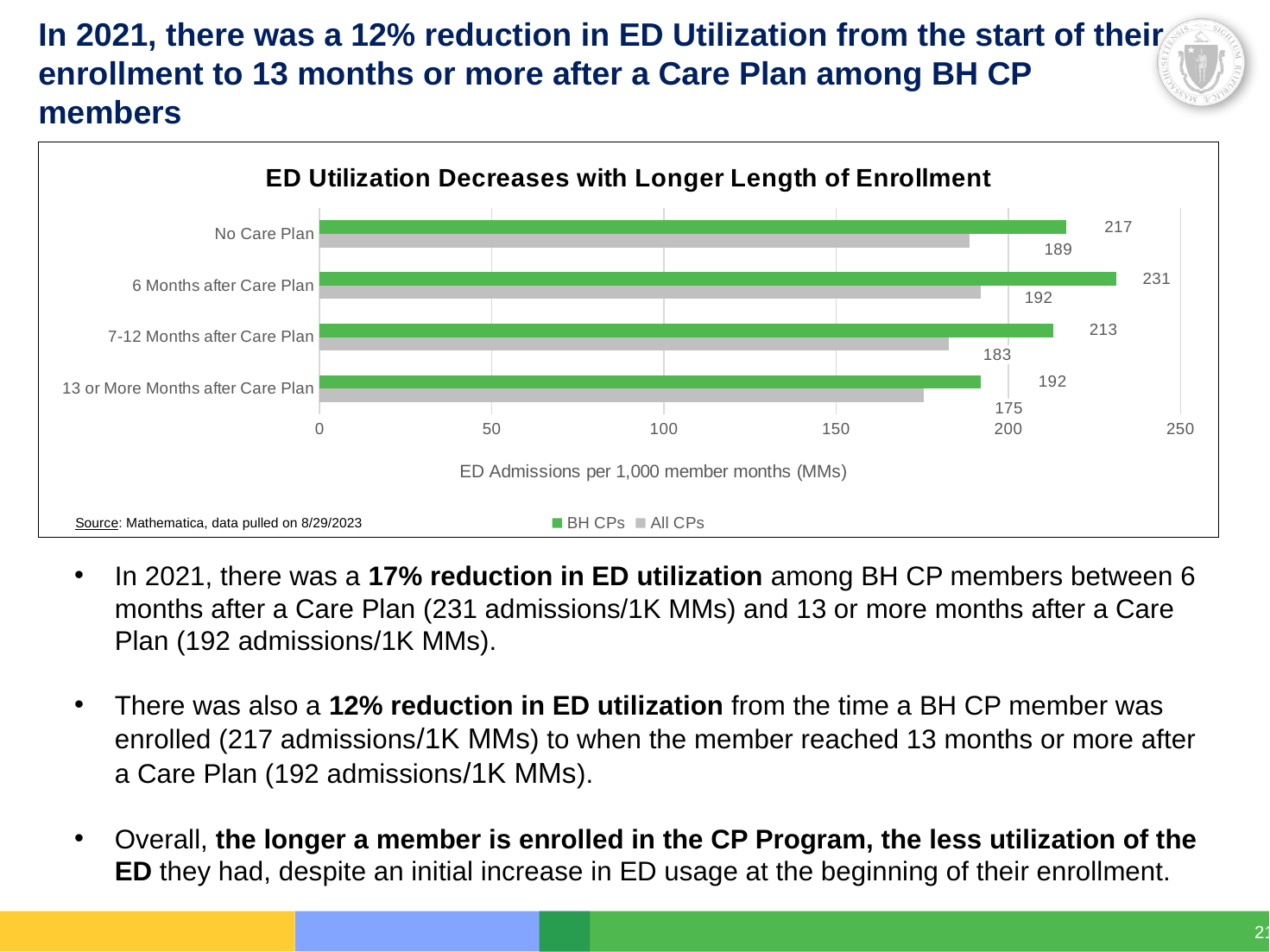
What is the difference between the BH CPs and All CPs values for 7-12 Months after Care Plan? 30 What is the All CPs value for No Care Plan? 189 What is the All CPs value for 13 or More Months after Care Plan? 175 What kind of chart is shown on the slide? Bar chart Which is larger: the BH CPs value for No Care Plan or the BH CPs value for 7-12 Months after Care Plan? No Care Plan What is the title of the chart? ED Utilization Decreases with Longer Length of Enrollment What is the difference between the BH CPs values for 6 Months after Care Plan and 13 or More Months after Care Plan? 39 How many categories are shown on the chart? 4 How many series does the legend list? 2 Which category has the lowest All CPs value? 13 or More Months after Care Plan What is the BH CPs value for 6 Months after Care Plan? 231 Which category has the highest BH CPs value? 6 Months after Care Plan